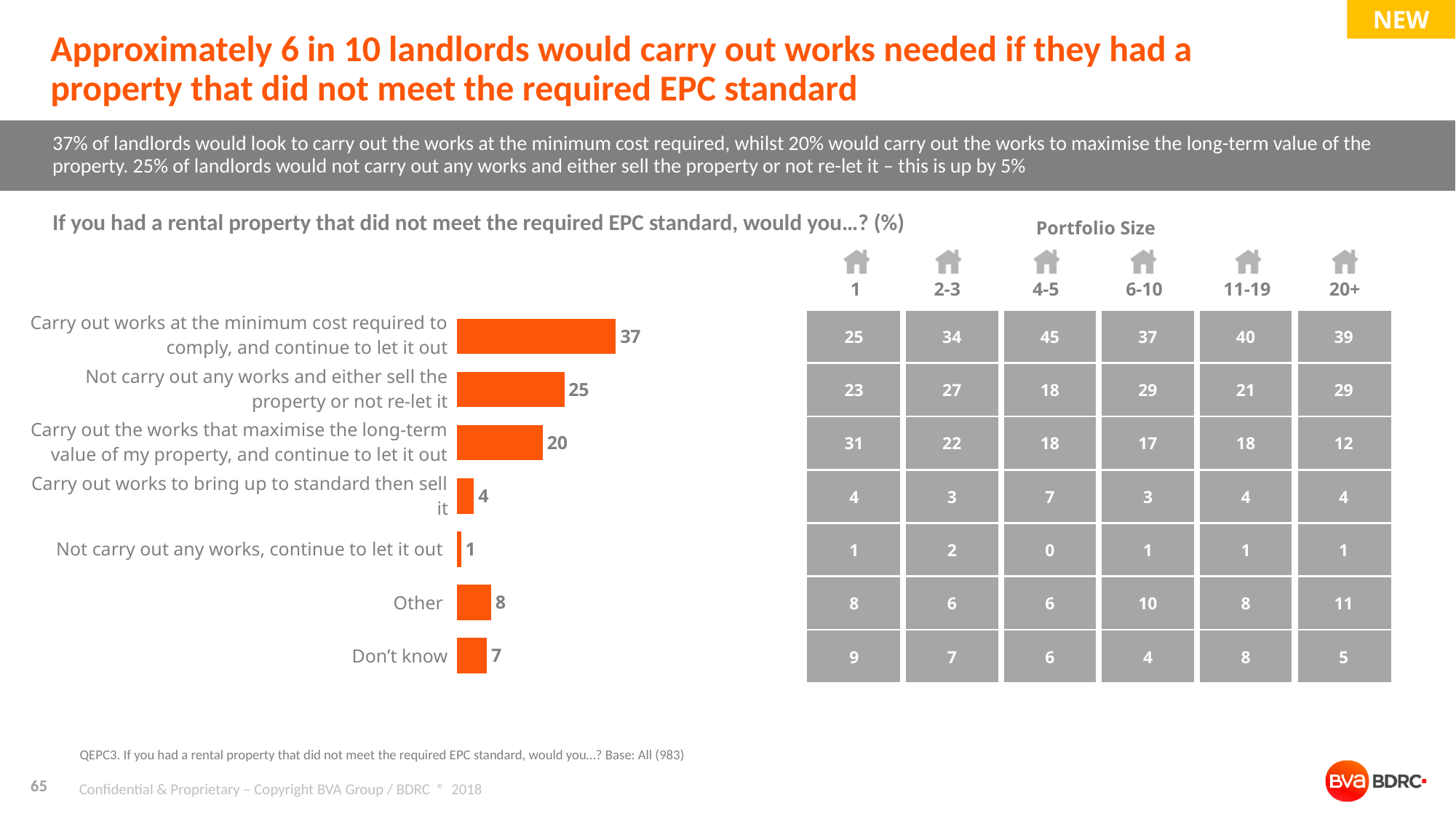
Which is larger: the value for 'Other' or the value for 'Don't know'? Other What is the value for 'Carry out works at the minimum cost required to comply, and continue to let it out'? 37 What is the value for 'Not carry out any works and either sell the property or not re-let it'? 25 What is the value for 'Don't know'? 7 What is the difference between the values for 'Carry out works to bring up to standard then sell it' and 'Not carry out any works, continue to let it out'? 3 Which category has the lowest value in the bar chart? Not carry out any works, continue to let it out What kind of chart is shown on the slide? Bar chart What is the difference between the values for 'Carry out works at the minimum cost required to comply, and continue to let it out' and 'Carry out the works that maximise the long-term value of my property, and continue to let it out'? 17 What is the title of the bar chart? If you had a rental property that did not meet the required EPC standard, would you…? (%) Which category has the highest value in the bar chart? Carry out works at the minimum cost required to comply, and continue to let it out How many categories are shown in the bar chart? 7 What colour are the bars in the chart? Orange